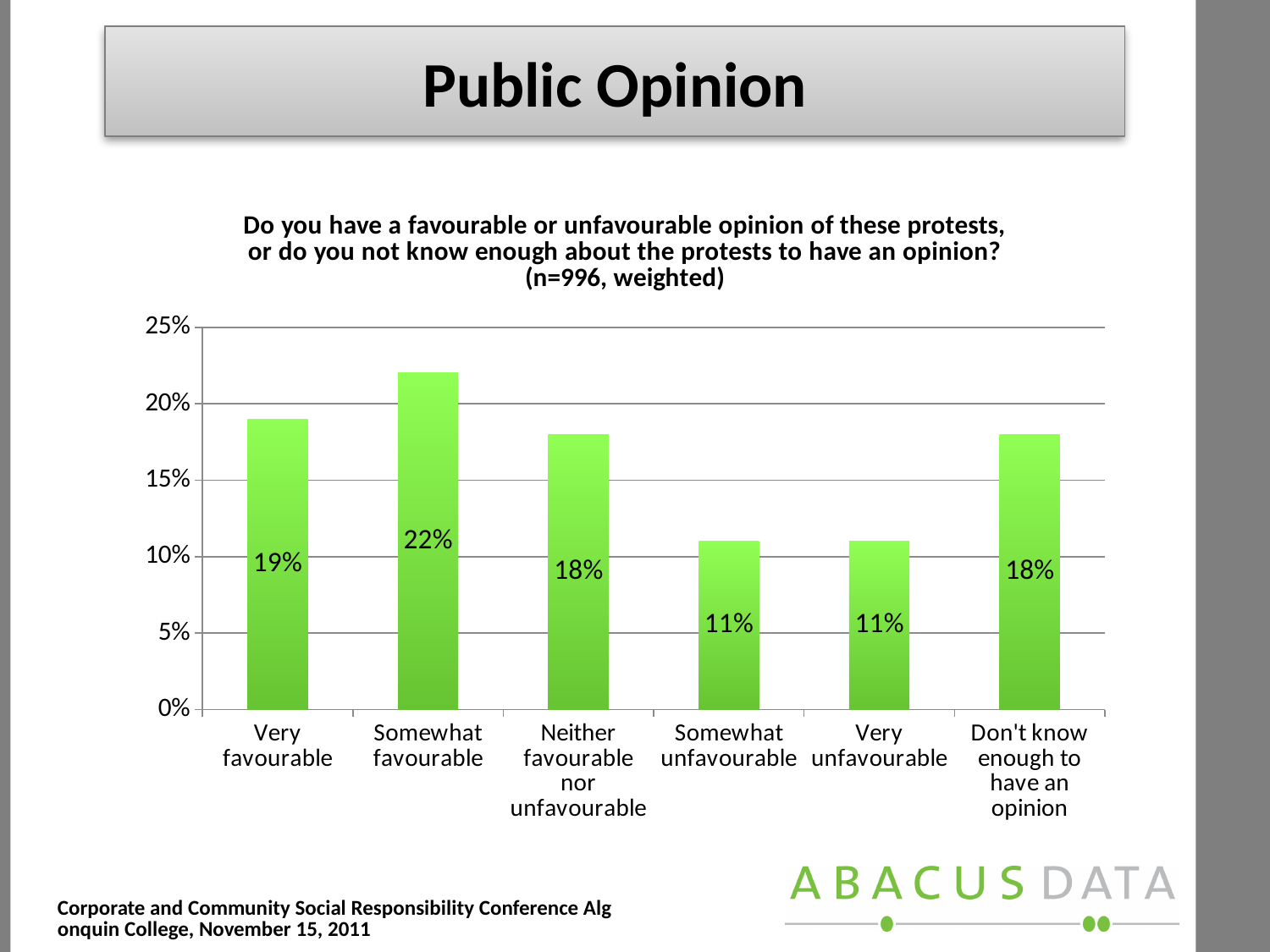
What is the value for 'Very unfavourable'? 11% Is the value for 'Somewhat favourable' greater or less than 20%? greater What percentage of respondents have a very favourable opinion of the protests? 19% Which category has the highest value? Somewhat favourable What is the sample size stated in the chart title? n=996, weighted What is the difference between 'Somewhat favourable' and 'Somewhat unfavourable'? 11% What percentage of respondents don't know enough to have an opinion? 18% What is the difference between 'Very favourable' and 'Neither favourable nor unfavourable'? 1% What is the value for 'Somewhat favourable'? 22% Which is larger, 'Very favourable' or 'Very unfavourable'? Very favourable What kind of chart is shown on the slide? Bar chart How many categories are shown on the x axis? 6